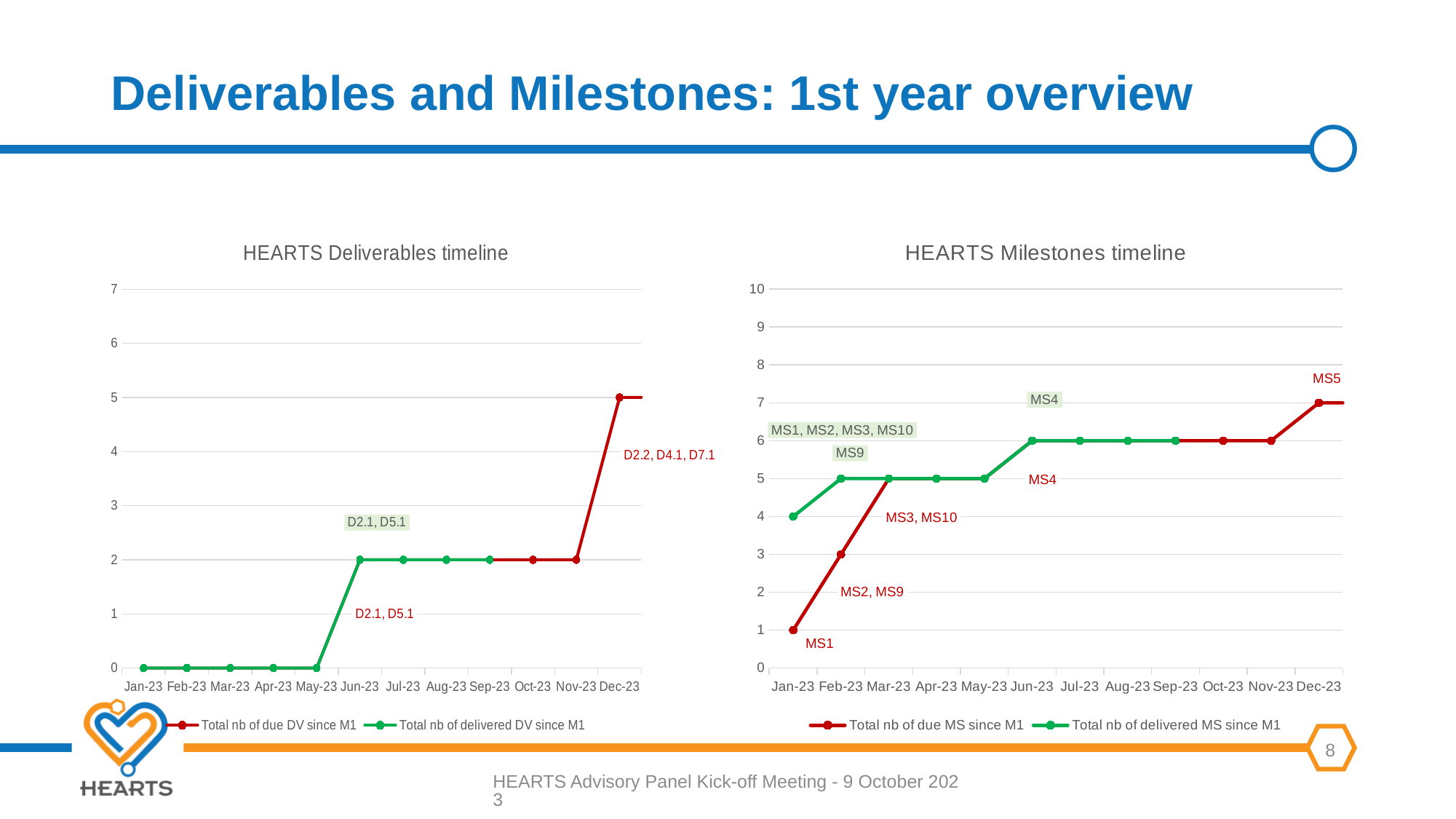
What kind of chart is the HEARTS Deliverables timeline? line chart What is the title of the chart on the right side of the slide? HEARTS Milestones timeline How many series does the legend of the HEARTS Milestones timeline chart list? 2 In the HEARTS Milestones timeline chart, what is the total number of delivered MS since M1 at Jan-23? 4 In the HEARTS Deliverables timeline chart, what is the total number of due DV since M1 at Dec-23? 5 In the HEARTS Deliverables timeline chart, do the values of the due DV series rise or fall from Jan-23 to Dec-23? rise In the HEARTS Milestones timeline chart, what is the total number of due MS since M1 at Dec-23? 7 In the HEARTS Milestones timeline chart, which month has the highest total number of due MS since M1? Dec-23 In the HEARTS Milestones timeline chart, what is the total number of due MS since M1 at Jan-23? 1 In the HEARTS Milestones timeline chart, what is the difference between the due MS at Dec-23 and the due MS at Jan-23? 6 In the HEARTS Deliverables timeline chart, what is the total number of delivered DV since M1 at Jun-23? 2 How many months are shown on the x axis of the HEARTS Deliverables timeline chart? 12